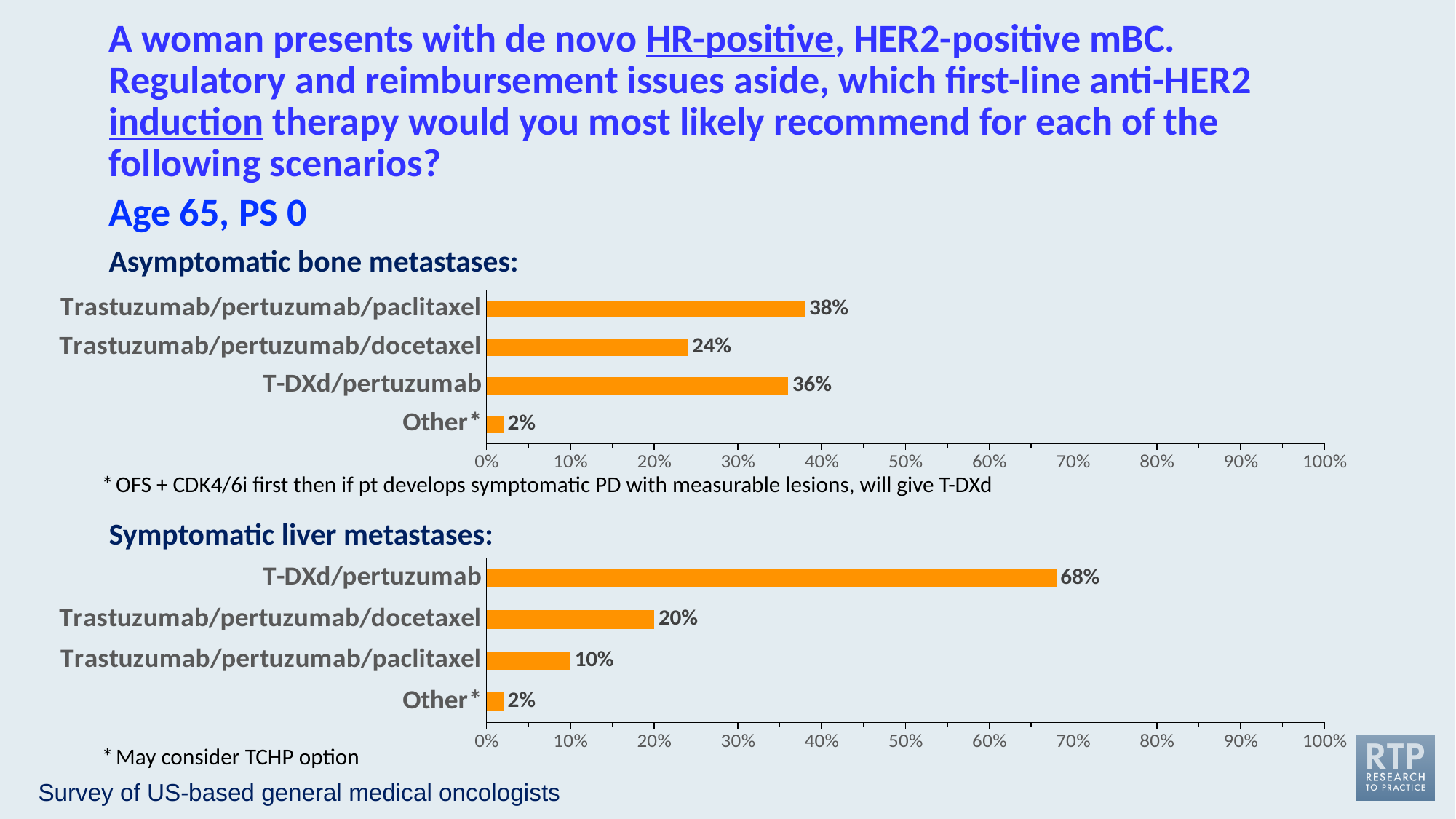
In the 'Symptomatic liver metastases' chart, is the value for T-DXd/pertuzumab greater or less than 60%? greater What kind of chart is used for 'Symptomatic liver metastases'? Bar chart In the 'Asymptomatic bone metastases' chart, which option has the highest percentage? Trastuzumab/pertuzumab/paclitaxel In the 'Symptomatic liver metastases' chart, what percentage chose Trastuzumab/pertuzumab/paclitaxel? 10% What is the maximum value shown on the x axis of the 'Asymptomatic bone metastases' chart? 100% How many options are shown in the 'Asymptomatic bone metastases' chart? 4 In the 'Symptomatic liver metastases' chart, what percentage chose T-DXd/pertuzumab? 68% In the 'Symptomatic liver metastases' chart, what is the difference between T-DXd/pertuzumab and Trastuzumab/pertuzumab/docetaxel? 48% In the 'Asymptomatic bone metastases' chart, what percentage chose Trastuzumab/pertuzumab/paclitaxel? 38% In the 'Asymptomatic bone metastases' chart, what is the difference between Trastuzumab/pertuzumab/paclitaxel and Trastuzumab/pertuzumab/docetaxel? 14% In the 'Asymptomatic bone metastases' chart, which is larger: T-DXd/pertuzumab or Trastuzumab/pertuzumab/docetaxel? T-DXd/pertuzumab In the 'Symptomatic liver metastases' chart, which option has the lowest percentage? Other*